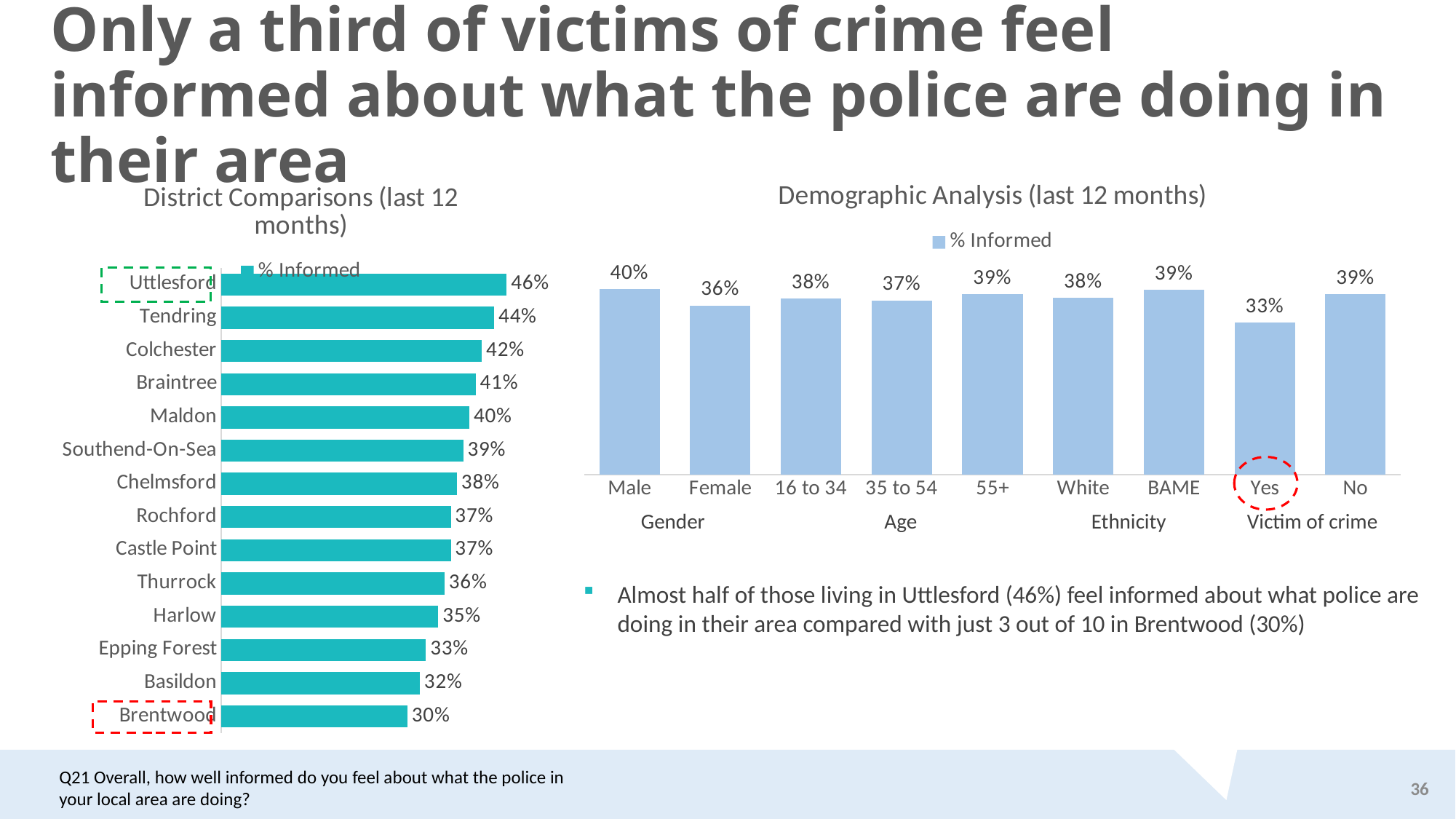
In the District Comparisons chart, which district has the highest % Informed value? Uttlesford In the Demographic Analysis chart, what is the % Informed value for victims of crime (Yes)? 33% In the District Comparisons chart, which district has the lowest % Informed value? Brentwood In the District Comparisons chart, what is the difference between the values for Uttlesford and Brentwood? 16 percentage points In the Demographic Analysis chart, what is the % Informed value for Female? 36% In the Demographic Analysis chart, which category has the lowest % Informed value? Yes (Victim of crime) In the District Comparisons chart, which has a higher value, Tendring or Harlow? Tendring What type of chart is the Demographic Analysis chart? Bar chart In the Demographic Analysis chart, how many categories are plotted? 9 In the District Comparisons chart, what is the % Informed value for Colchester? 42% In the Demographic Analysis chart, what is the difference between the values for Male and Female? 4 percentage points In the District Comparisons chart, how many districts are shown? 14